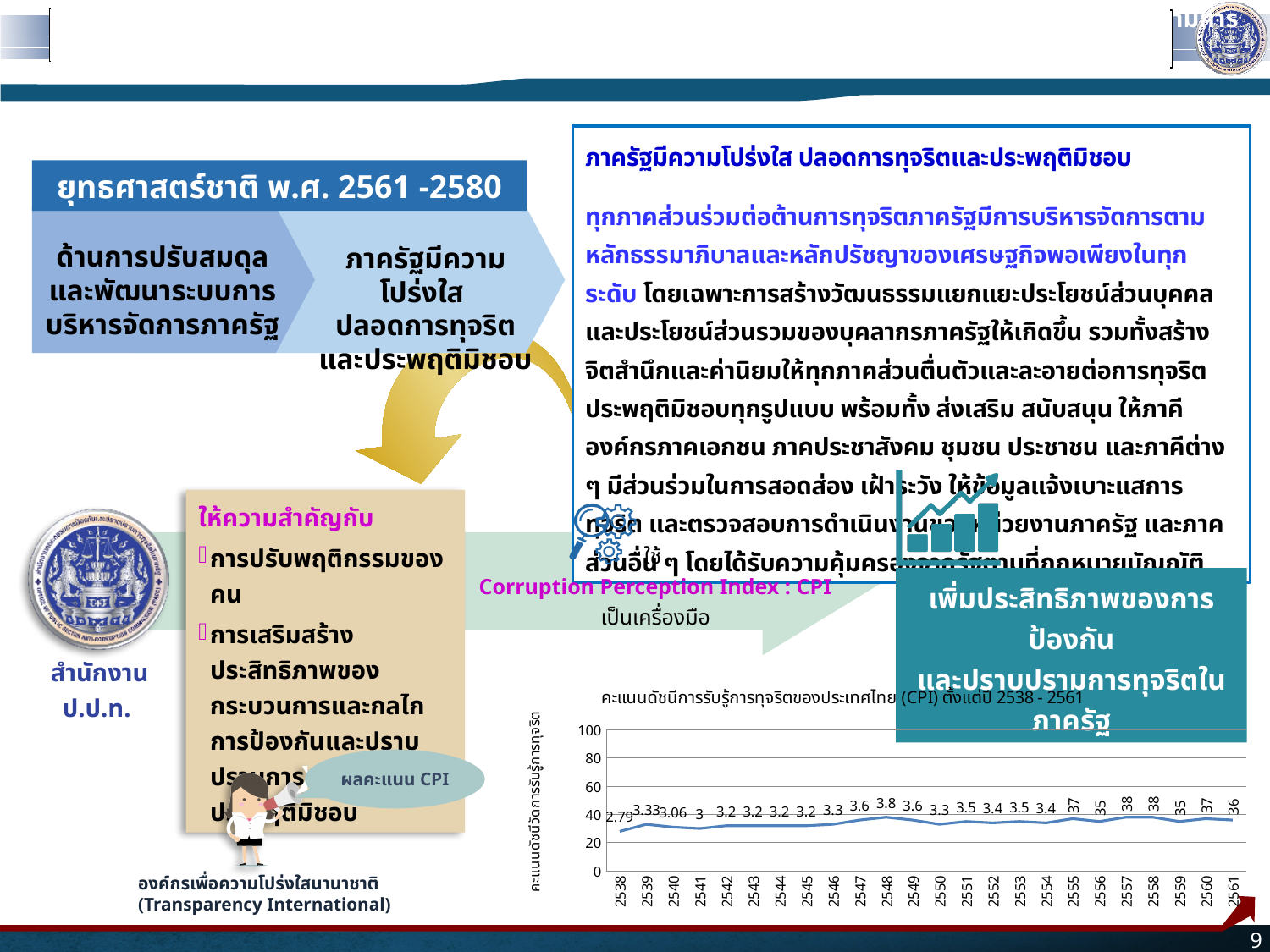
In the CPI chart, what is the data label for the year 2548? 3.8 In the CPI chart, what is the difference between the labelled values for 2557 and 2561? 2 What is the title of the chart at the bottom of the slide? คะแนนดัชนีการรับรู้การทุจริตของประเทศไทย (CPI) ตั้งแต่ปี 2538 - 2561 In the CPI chart, does the labelled value rise or fall from 2555 to 2556? fall What type of chart is shown at the bottom of the slide? line chart In the CPI chart, which year has the larger labelled value, 2559 or 2560? 2560 How many years are shown on the x axis of the CPI chart? 24 In the CPI chart, what is the data label for the year 2561? 36 In the CPI chart, what is the data label for the year 2557? 38 In the CPI chart, what is the data label for the year 2538? 2.79 In the CPI chart, is the value for 2561 greater or less than 60? less In the CPI chart, what is the data label for the year 2539? 3.33